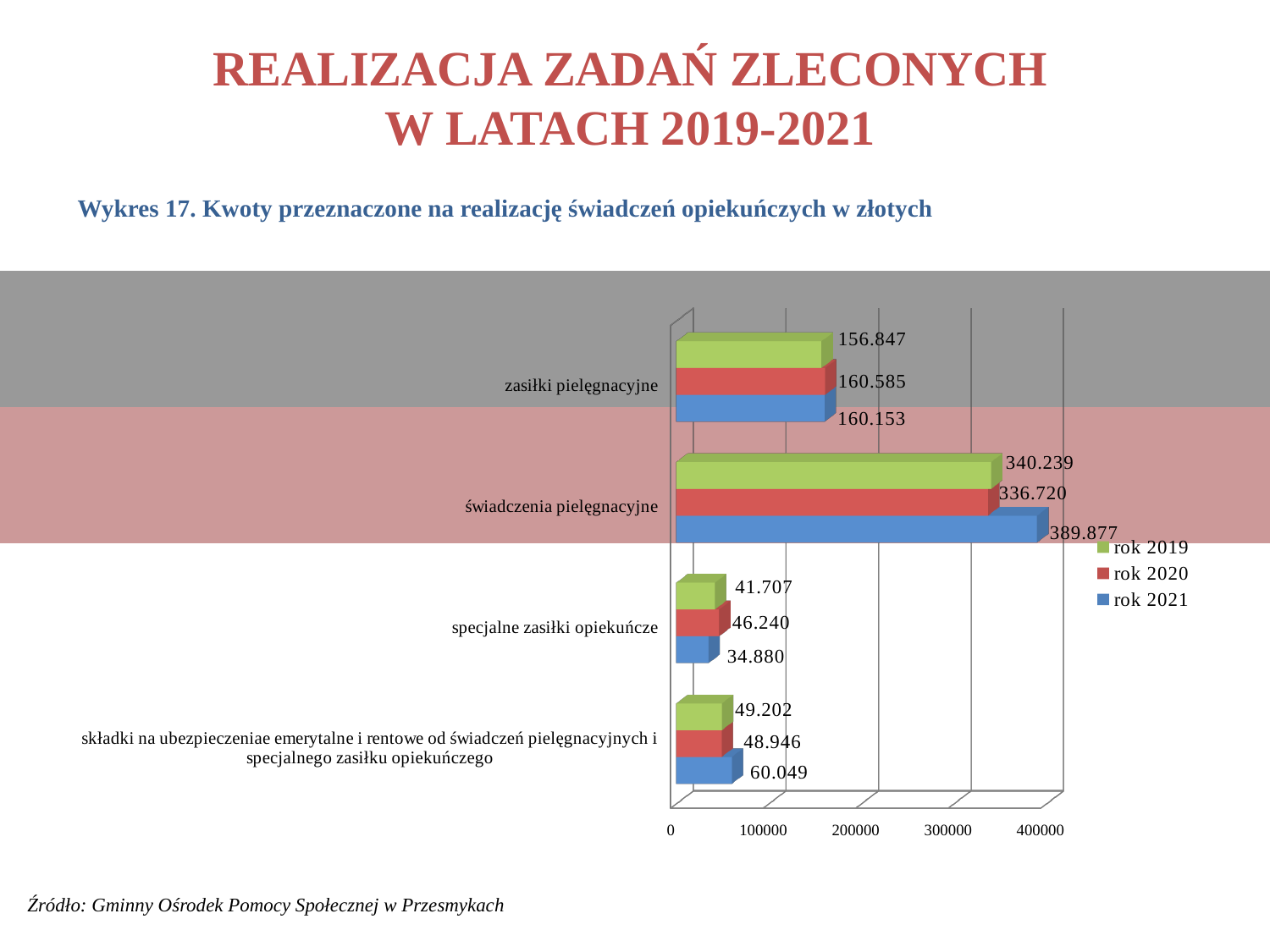
What is the value for rok 2019 for zasiłki pielęgnacyjne? 156.847 Which category has the lowest value for rok 2021? specjalne zasiłki opiekuńcze Which is larger for specjalne zasiłki opiekuńcze: the rok 2019 value or the rok 2021 value? rok 2019 How many series does the legend list? 3 Is the rok 2019 value for świadczenia pielęgnacyjne greater or less than 300000? greater What is the value for rok 2020 for specjalne zasiłki opiekuńcze? 46.240 What kind of chart is shown on the slide? bar chart How many categories are shown on the chart? 4 What is the value for rok 2021 for składki na ubezpieczenia emerytalne i rentowe od świadczeń pielęgnacyjnych i specjalnego zasiłku opiekuńczego? 60.049 What is the difference between the rok 2021 and rok 2020 values for świadczenia pielęgnacyjne? 53.157 Which category has the highest value for rok 2021? świadczenia pielęgnacyjne What is the value for rok 2021 for świadczenia pielęgnacyjne? 389.877